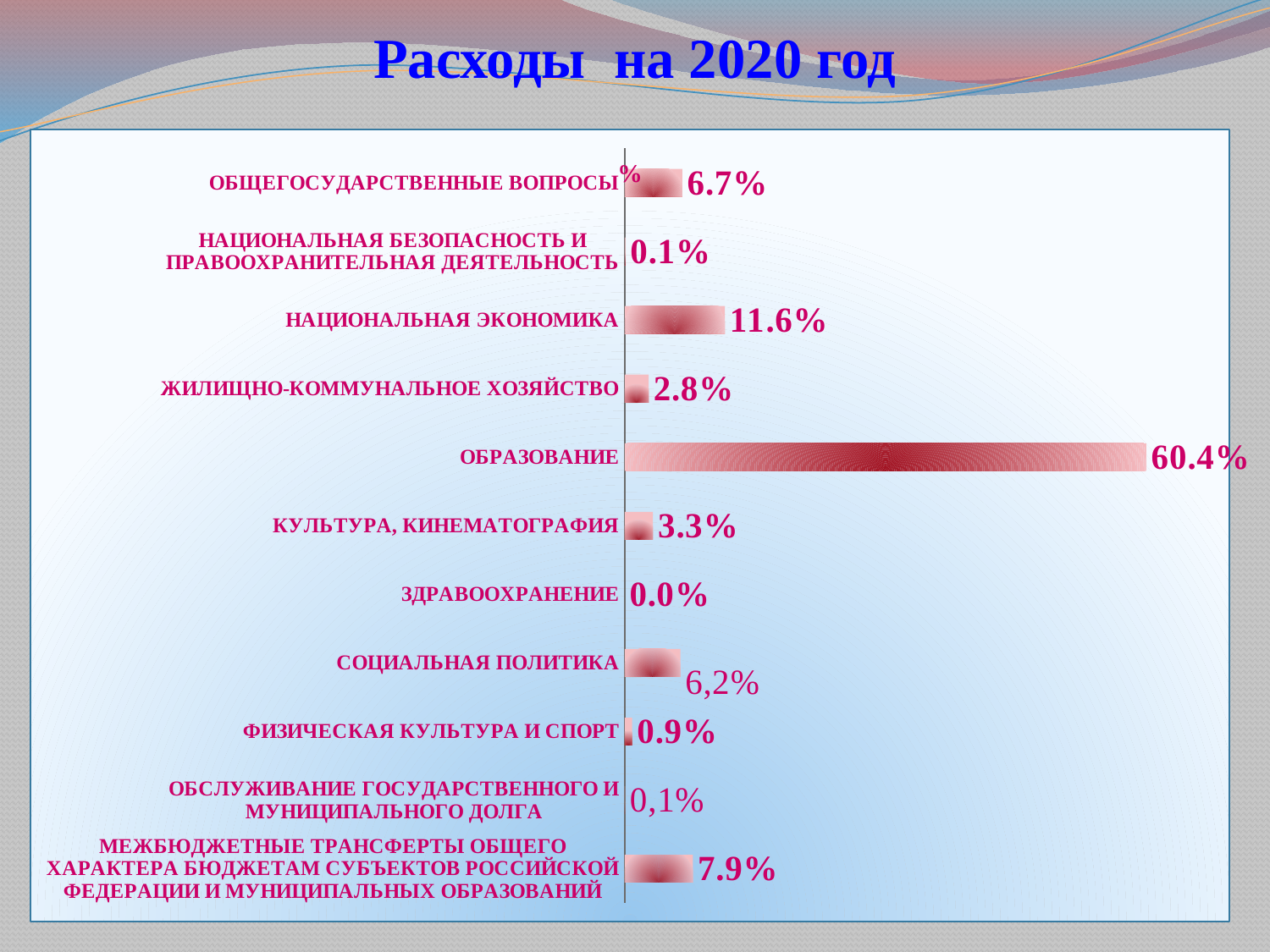
Which category has the lowest value? ЗДРАВООХРАНЕНИЕ What is the difference between the values for ОБРАЗОВАНИЕ and НАЦИОНАЛЬНАЯ ЭКОНОМИКА? 48.8% What is the value for ОБРАЗОВАНИЕ? 60.4% How many categories are shown in the chart? 11 Which category has the highest value? ОБРАЗОВАНИЕ What is the value for ЖИЛИЩНО-КОММУНАЛЬНОЕ ХОЗЯЙСТВО? 2.8% What is the value for ФИЗИЧЕСКАЯ КУЛЬТУРА И СПОРТ? 0.9% What is the value for СОЦИАЛЬНАЯ ПОЛИТИКА? 6,2% What is the title of the chart? Расходы на 2020 год What is the value for НАЦИОНАЛЬНАЯ ЭКОНОМИКА? 11.6% What type of chart is shown on the slide? Bar chart Which is larger: the value for ОБЩЕГОСУДАРСТВЕННЫЕ ВОПРОСЫ or the value for МЕЖБЮДЖЕТНЫЕ ТРАНСФЕРТЫ ОБЩЕГО ХАРАКТЕРА БЮДЖЕТАМ СУБЪЕКТОВ РОССИЙСКОЙ ФЕДЕРАЦИИ И МУНИЦИПАЛЬНЫХ ОБРАЗОВАНИЙ? МЕЖБЮДЖЕТНЫЕ ТРАНСФЕРТЫ ОБЩЕГО ХАРАКТЕРА БЮДЖЕТАМ СУБЪЕКТОВ РОССИЙСКОЙ ФЕДЕРАЦИИ И МУНИЦИПАЛЬНЫХ ОБРАЗОВАНИЙ